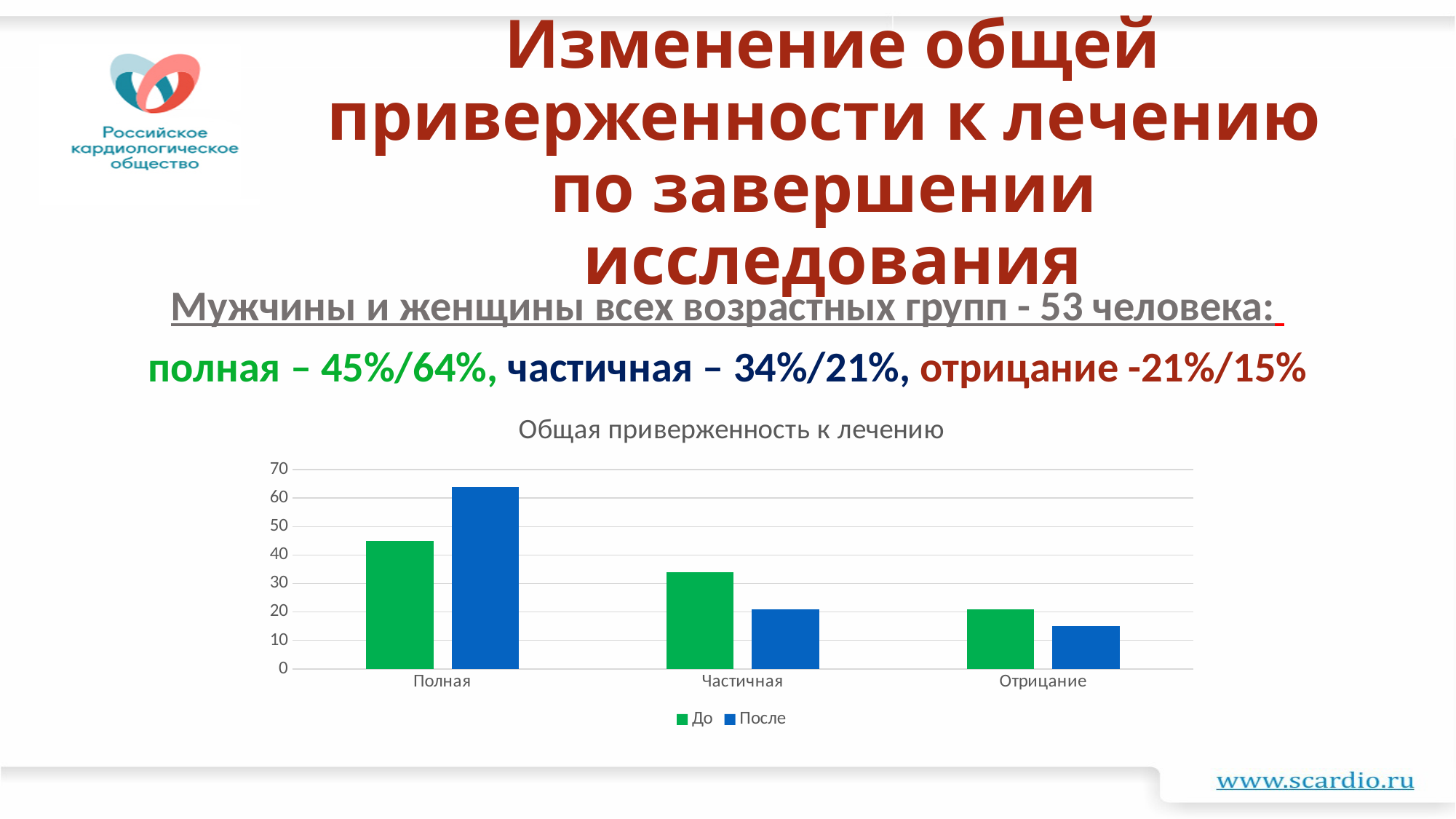
For the 'Полная' category, which series has the larger value, 'До' or 'После'? После Which category has the lowest value for the 'После' series? Отрицание For the 'Частичная' category, which series has the larger value, 'До' or 'После'? До Is the 'После' value for 'Полная' greater or less than 60? greater Which category has the highest value for the 'После' series? Полная What is the title of the chart? Общая приверженность к лечению Which category has the highest value for the 'До' series? Полная Which series is shown in blue in the chart? После What kind of chart is shown on the slide? bar chart How many categories are shown on the x axis of the chart? 3 How many series does the chart legend list? 2 Is the 'До' value for 'Частичная' greater or less than 30? greater